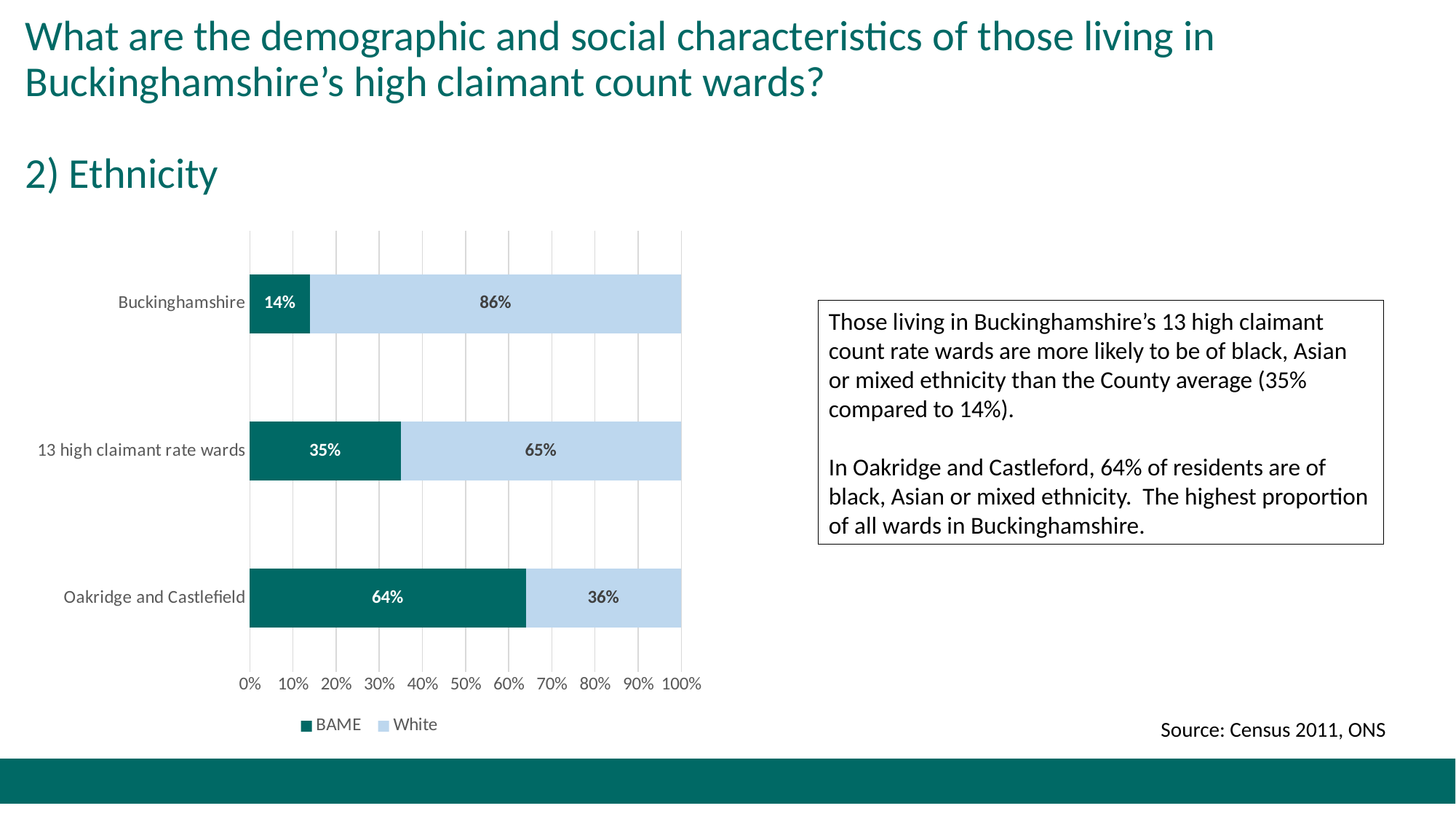
How many categories are shown on the chart? 3 What is the BAME value for Buckinghamshire? 14% What kind of chart is shown on the slide? Stacked bar chart What is the BAME value for Oakridge and Castlefield? 64% Which category has the lowest White value? Oakridge and Castlefield What is the difference between the BAME value for the 13 high claimant rate wards and the BAME value for Buckinghamshire? 21% What is the total of the stacked bar for the 13 high claimant rate wards? 100% Which category has the highest BAME value? Oakridge and Castlefield How many series does the legend list? 2 What is the White value for Buckinghamshire? 86% Which is larger: the BAME value for Oakridge and Castlefield or the White value for Oakridge and Castlefield? BAME What is the White value for the 13 high claimant rate wards? 65%